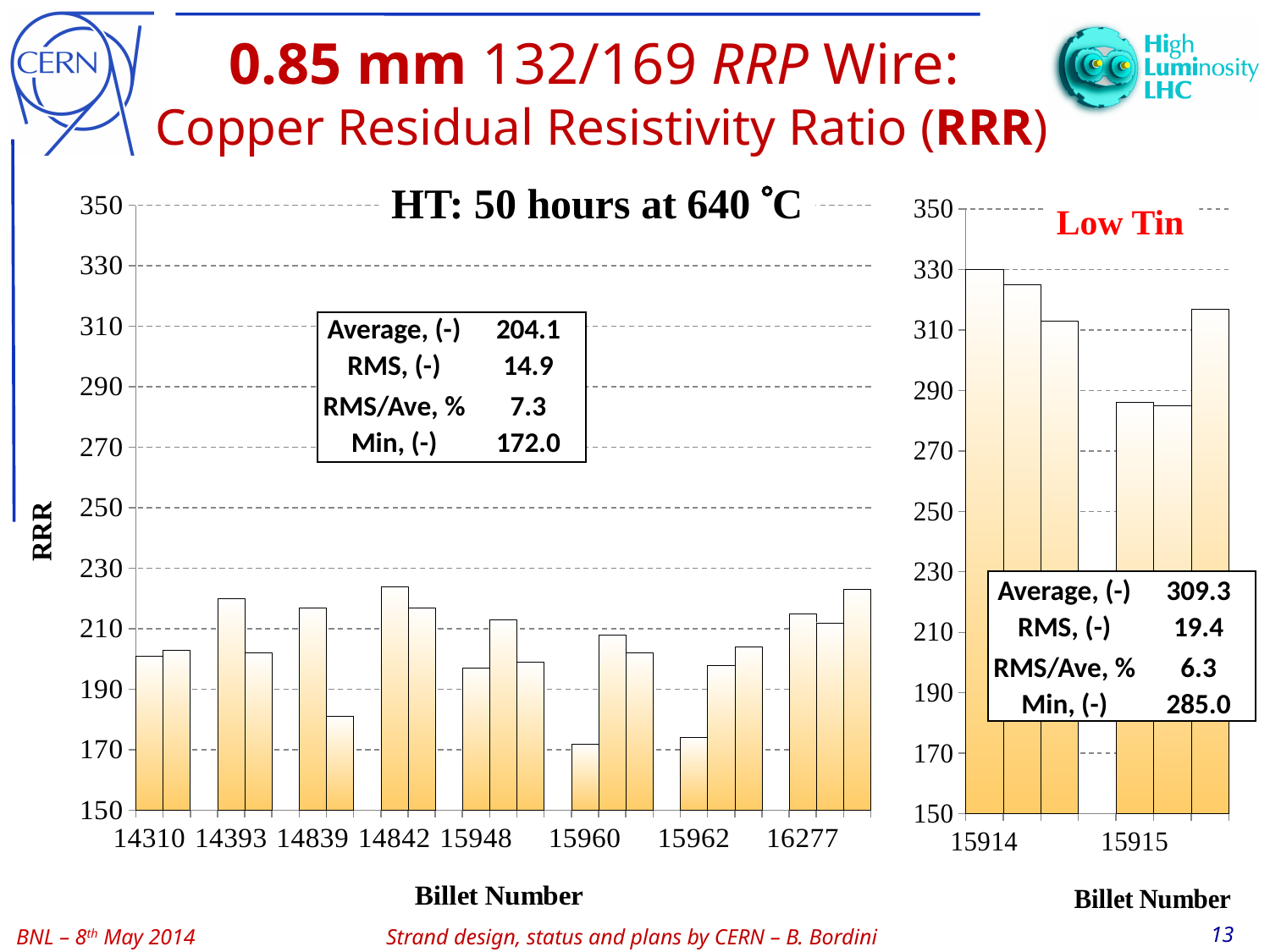
In the right chart (Low Tin), which is larger: the first bar for billet 15914 or the first bar for billet 15915? 15914 In the left chart (HT: 50 hours at 640 °C), which is larger: the first bar for billet 14842 or the first bar for billet 15960? 14842 What kind of chart is the left chart titled 'HT: 50 hours at 640 °C'? bar chart In the left chart (HT: 50 hours at 640 °C), how many billet numbers are labelled on the x axis? 8 What is the label on the y axis of the left chart (HT: 50 hours at 640 °C)? RRR In the left chart (HT: 50 hours at 640 °C), is the value of the first bar for billet 15960 greater or less than 190? less What kind of chart is the right chart titled 'Low Tin'? bar chart In the left chart (HT: 50 hours at 640 °C), is the value of the first bar for billet 14842 greater or less than 210? greater In the right chart (Low Tin), how many billet numbers are labelled on the x axis? 2 In the right chart (Low Tin), is the value of the first bar for billet 15914 greater or less than 310? greater What is the title of the right chart? Low Tin